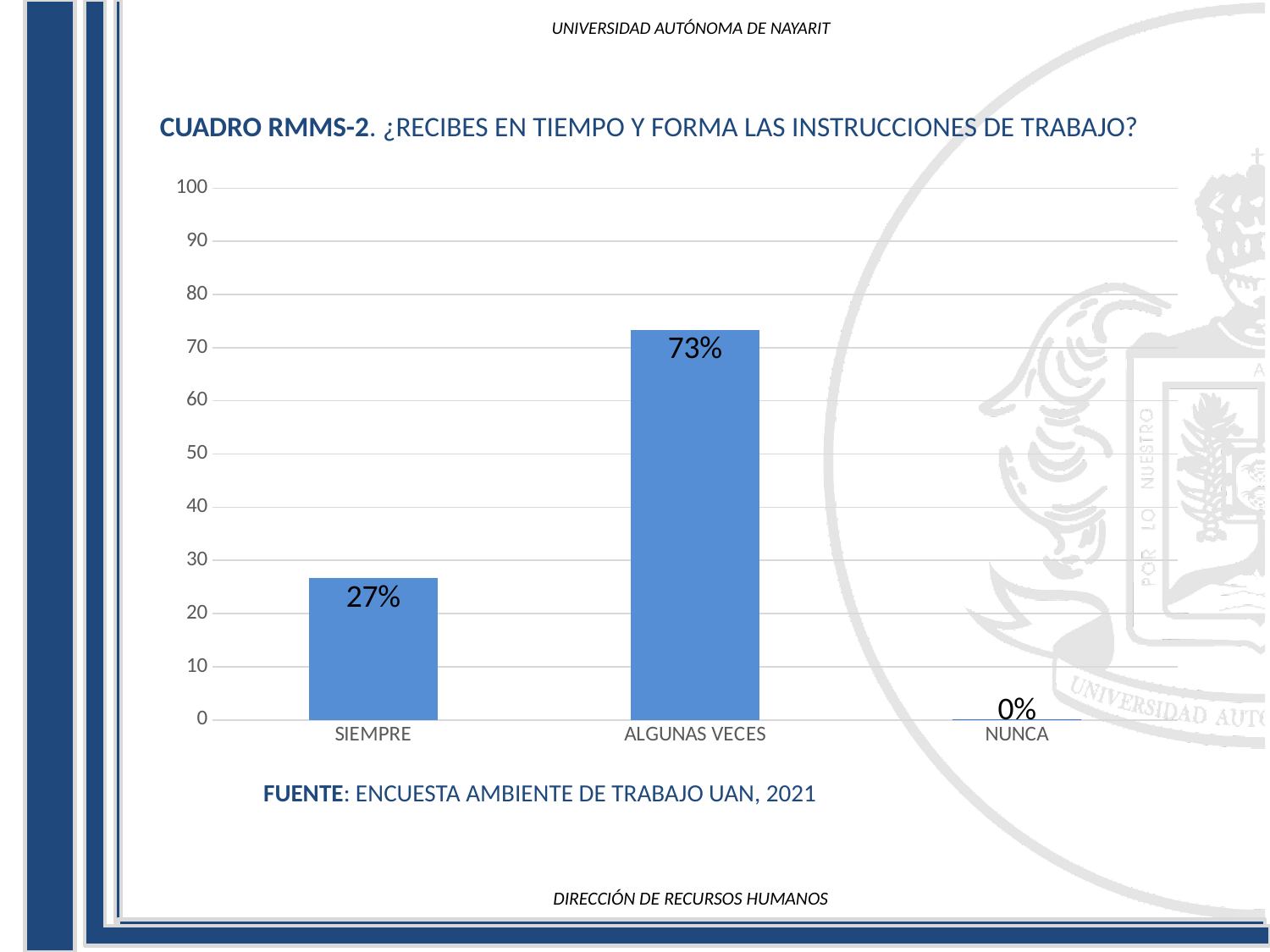
What is the value for NUNCA? 0% What is the value for ALGUNAS VECES? 73% Is the value for SIEMPRE greater or less than 30? less What kind of chart is shown on the slide? bar chart What is the value for SIEMPRE? 27% Which category has the highest value? ALGUNAS VECES What source is cited below the chart? ENCUESTA AMBIENTE DE TRABAJO UAN, 2021 How many categories are shown on the x axis? 3 Which category has the lowest value? NUNCA What is the difference between the values for ALGUNAS VECES and SIEMPRE? 46% Is the value for ALGUNAS VECES greater or less than 70? greater Which is larger, the value for SIEMPRE or the value for ALGUNAS VECES? ALGUNAS VECES